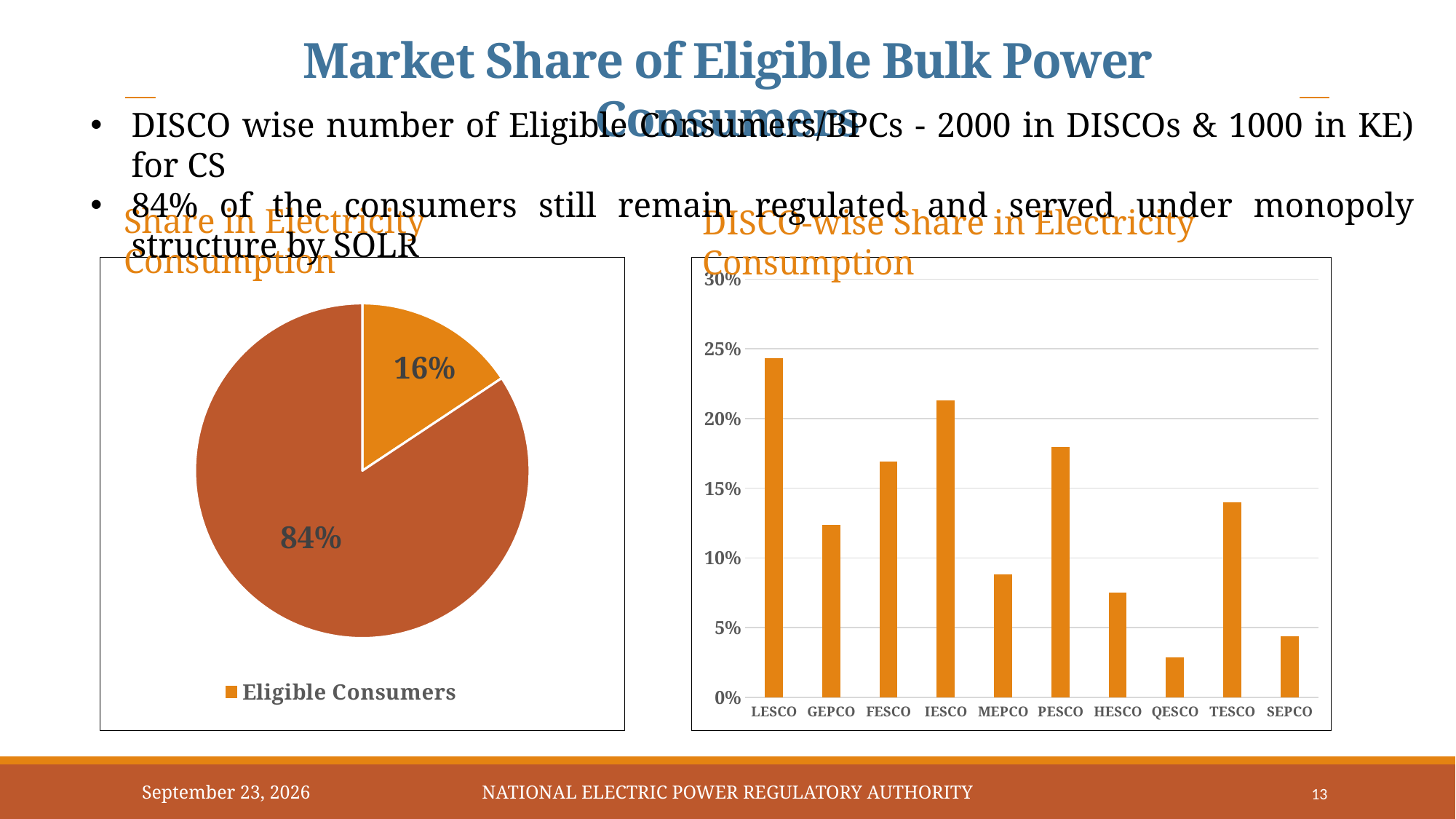
On the chart titled 'DISCO-wise Share in Electricity Consumption', which has the larger share, TESCO or SEPCO? TESCO On the pie chart on the left, what is the only entry listed in the legend? Eligible Consumers What kind of chart is the chart titled 'DISCO-wise Share in Electricity Consumption'? bar chart On the chart titled 'DISCO-wise Share in Electricity Consumption', how many DISCOs are shown on the x axis? 10 On the chart titled 'DISCO-wise Share in Electricity Consumption', is the value for MEPCO greater or less than 10%? less On the chart titled 'DISCO-wise Share in Electricity Consumption', which DISCO has the lowest share? QESCO On the chart titled 'DISCO-wise Share in Electricity Consumption', is the value for LESCO greater or less than 20%? greater On the chart titled 'DISCO-wise Share in Electricity Consumption', which DISCO has the highest share? LESCO On the pie chart titled 'Share in Electricity Consumption', what share is shown for the larger slice? 84% On the chart titled 'DISCO-wise Share in Electricity Consumption', which has the larger share, IESCO or PESCO? IESCO On the chart titled 'DISCO-wise Share in Electricity Consumption', is the value for QESCO greater or less than 5%? less On the pie chart titled 'Share in Electricity Consumption', what share is shown for the orange slice? 16%